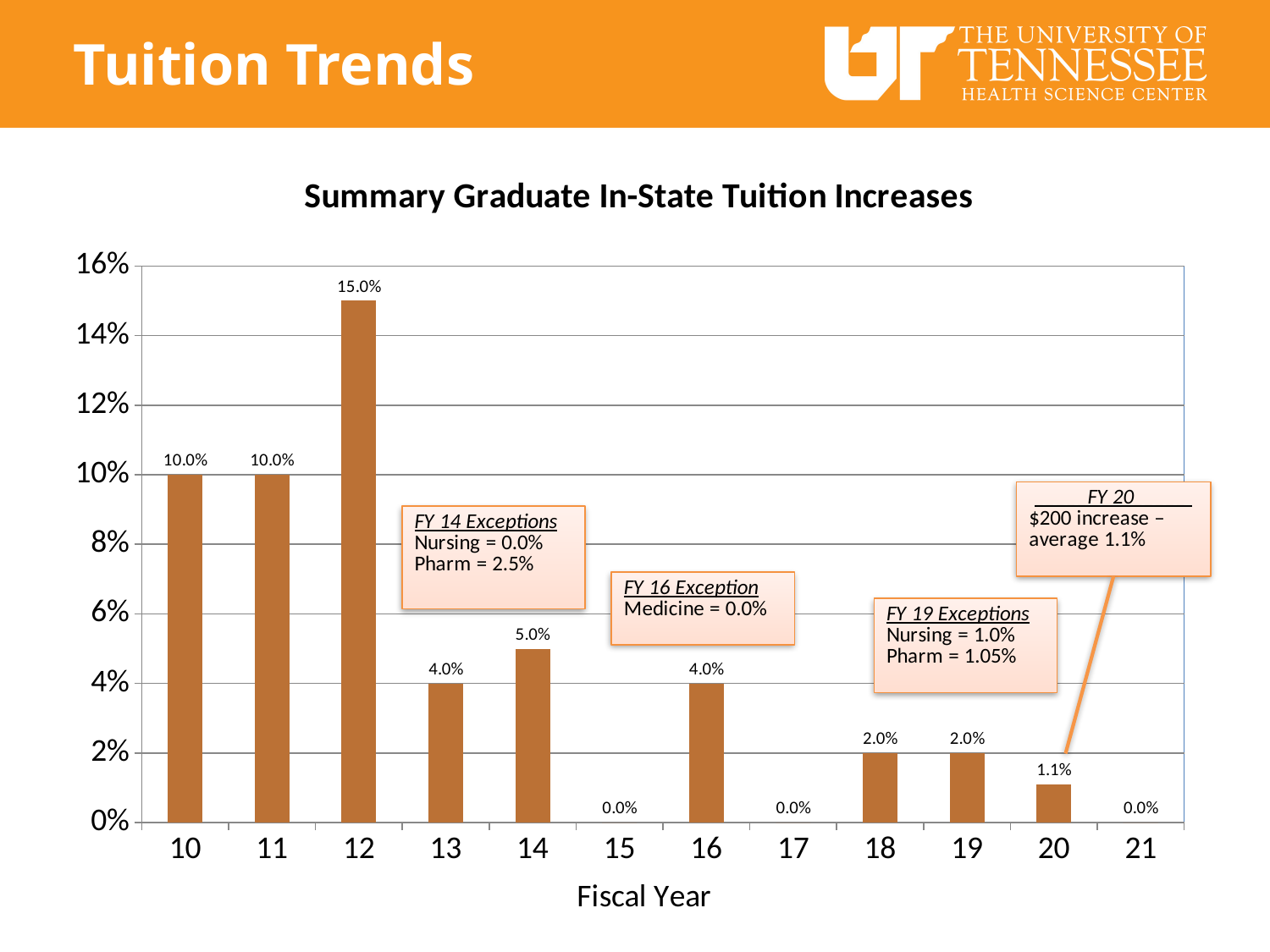
What kind of chart is shown on the slide? bar chart Which fiscal year has the highest tuition increase? 12 Which is larger, the tuition increase for fiscal year 13 or fiscal year 14? fiscal year 14 Is the value for fiscal year 11 greater or less than 8%? greater What is the title of the chart? Summary Graduate In-State Tuition Increases How many fiscal years are shown on the x axis? 12 What is the difference between the tuition increase in fiscal year 12 and fiscal year 14? 10.0% What is the tuition increase for fiscal year 20? 1.1% What is the tuition increase for fiscal year 12? 15.0% How many fiscal years show a 0.0% tuition increase? 3 What is the difference between the tuition increase in fiscal year 18 and fiscal year 20? 0.9% What is the tuition increase for fiscal year 14? 5.0%